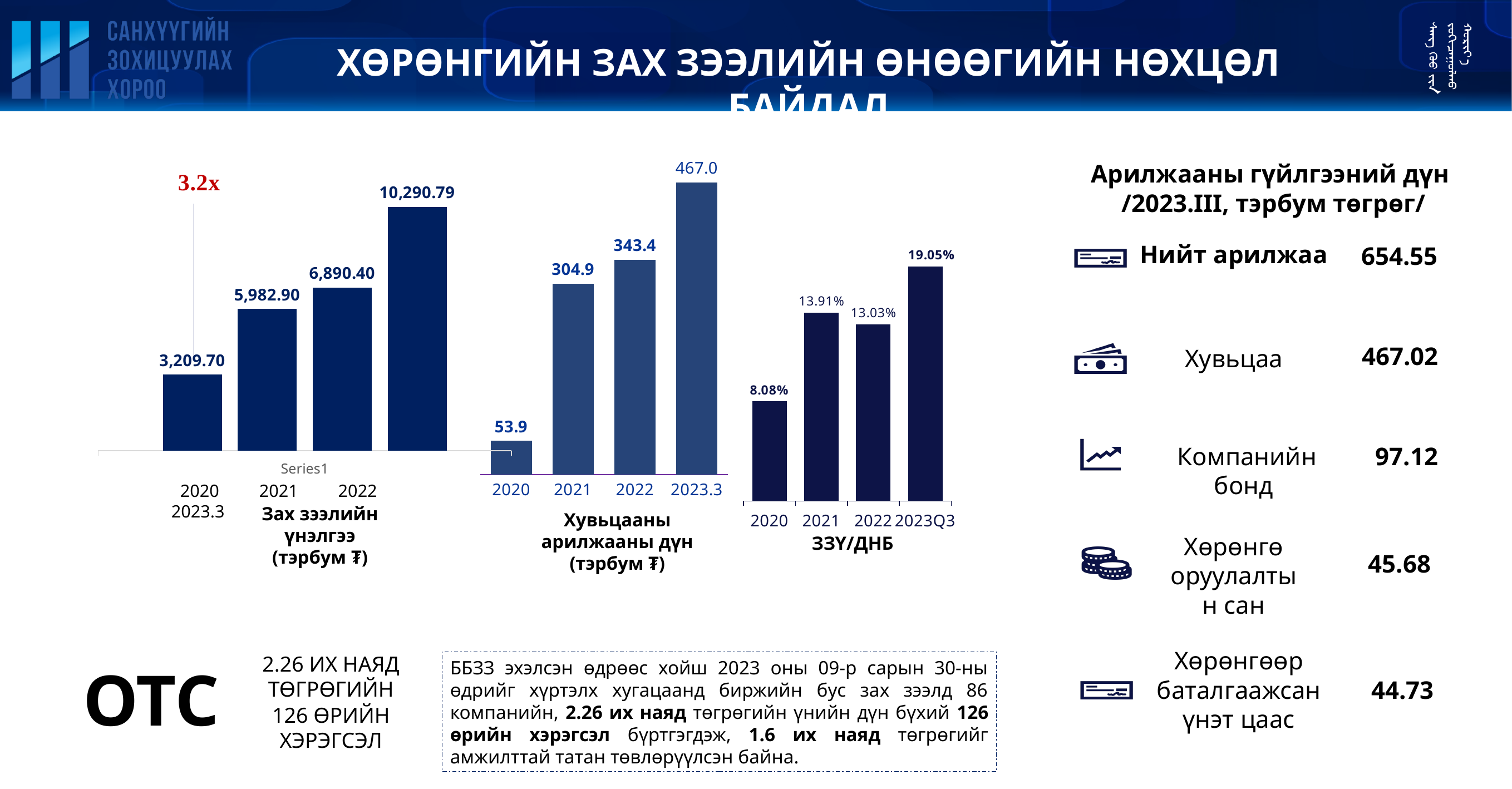
In the 'Зах зээлийн үнэлгээ (тэрбум ₮)' chart, what is the difference between the 2022 and 2021 values? 907.50 In the 'Хувьцааны арилжааны дүн (тэрбум ₮)' chart, do the values rise or fall from 2020 to 2023.3? rise In the 'Хувьцааны арилжааны дүн (тэрбум ₮)' chart, what is the value for 2020? 53.9 In the 'Зах зээлийн үнэлгээ (тэрбум ₮)' chart, which year has the highest value? 2023.3 What type of chart is the 'Хувьцааны арилжааны дүн (тэрбум ₮)' chart? bar chart In the 'Хувьцааны арилжааны дүн (тэрбум ₮)' chart, what is the difference between the 2023.3 and 2022 values? 123.6 In the 'ЗЗҮ/ДНБ' chart, which is larger, the value for 2021 or the value for 2022? 2021 In the 'Зах зээлийн үнэлгээ (тэрбум ₮)' chart, what is the value for 2021? 5,982.90 In the 'Хувьцааны арилжааны дүн (тэрбум ₮)' chart, which year has the lowest value? 2020 In the 'ЗЗҮ/ДНБ' chart, what is the value for 2023Q3? 19.05% How many bars are in the 'ЗЗҮ/ДНБ' chart? 4 In the 'ЗЗҮ/ДНБ' chart, what is the value for 2021? 13.91%